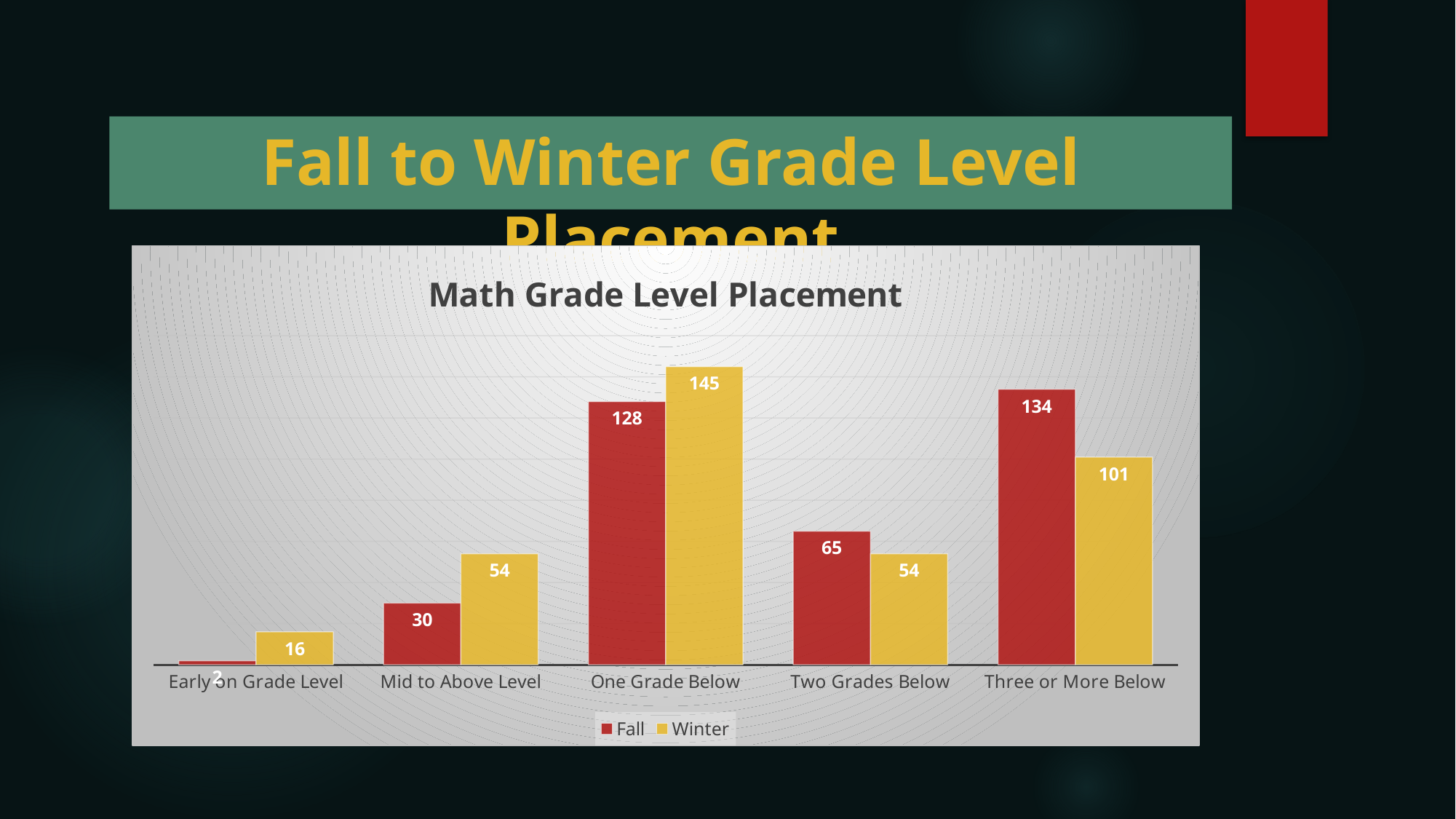
How many categories are shown on the x axis? 5 What type of chart is shown? Bar chart What is the Fall value for Three or More Below? 134 What is the Winter value for One Grade Below? 145 How many series does the legend list? 2 Which category has the highest Winter value? One Grade Below What is the Winter value for Early on Grade Level? 16 For Mid to Above Level, which is larger, the Fall value or the Winter value? Winter What is the Fall value for Two Grades Below? 65 What is the difference between the Winter and Fall values for One Grade Below? 17 Which category has the lowest Fall value? Early on Grade Level What is the difference between the Fall and Winter values for Three or More Below? 33